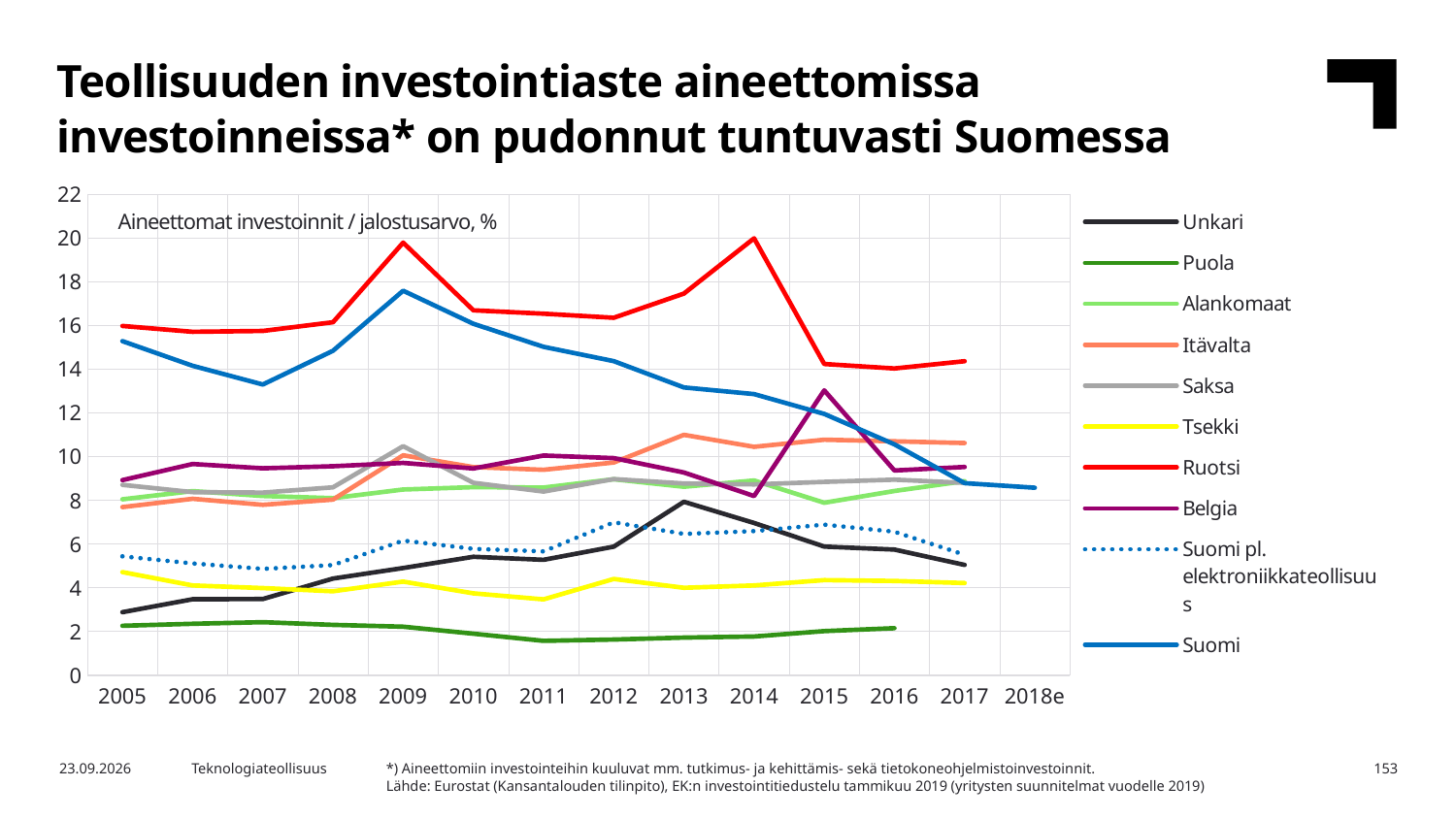
Is the value for Puola in 2011 greater or less than 2? less What kind of chart is shown on the slide? line chart In which year does the Suomi line reach its highest value? 2009 How many series does the legend list? 10 Which series has the highest value in 2014? Ruotsi Does the Suomi line rise or fall from 2005 to 2018e? fall Is the value for Ruotsi in 2014 greater or less than 18? greater How many years are shown on the x axis? 14 Which is larger in 2015, Belgia or Saksa? Belgia Which series has the lowest value in 2010? Puola Which series is drawn with a dotted line? Suomi pl. elektroniikkateollisuus Is the value for Suomi in 2018e greater or less than 10? less